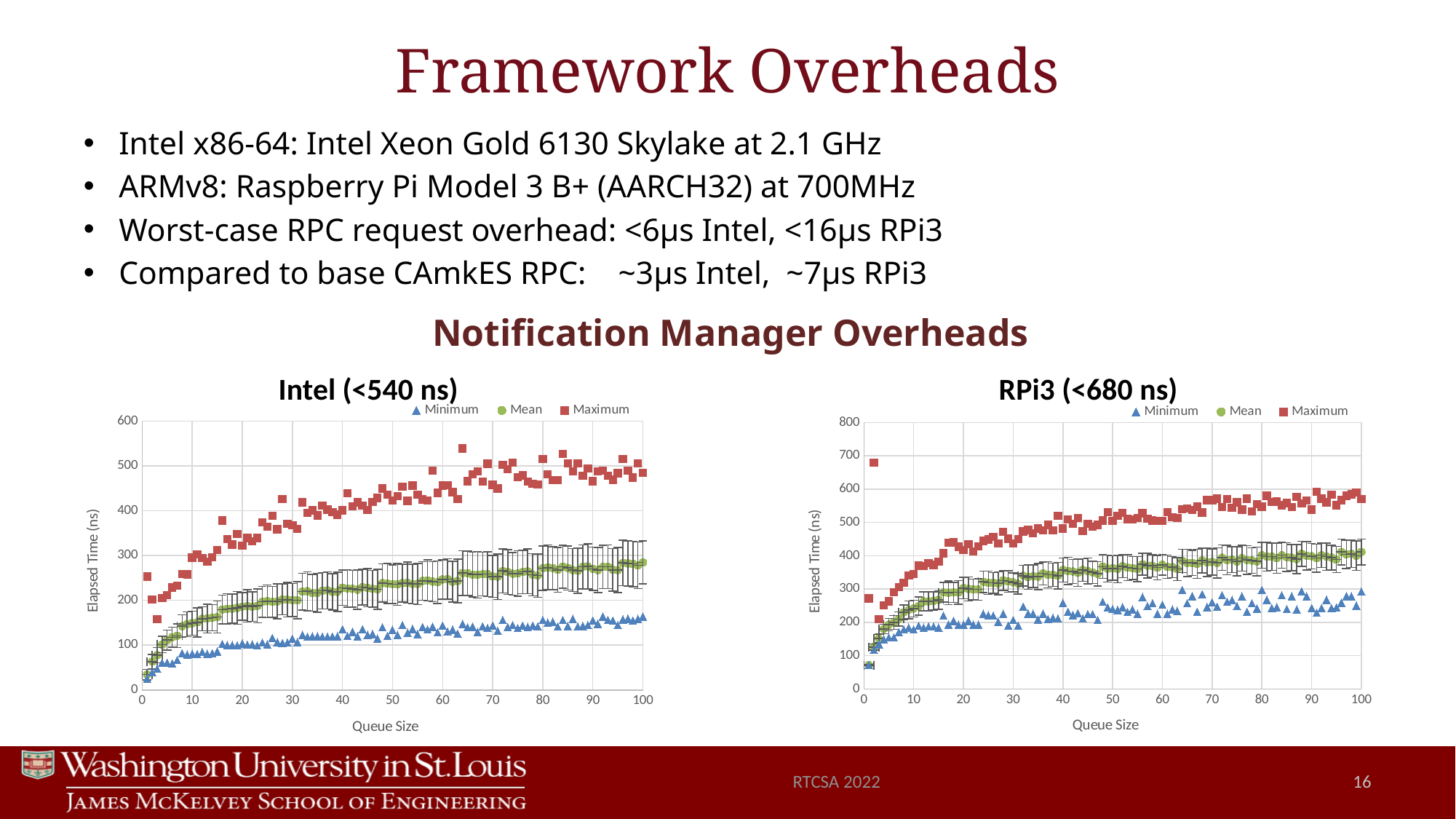
In the RPi3 (<680 ns) chart, which series has the larger value at queue size 80, Mean or Minimum? Mean What kind of chart is the Intel (<540 ns) chart? scatter chart How many series does the legend of the RPi3 (<680 ns) chart list? 3 In the Intel (<540 ns) chart, which series has the larger value at queue size 50, Maximum or Minimum? Maximum In the Intel (<540 ns) chart, does the Mean series rise or fall as Queue Size increases? rise In the RPi3 (<680 ns) chart, does the Maximum series rise or fall as Queue Size increases? rise In the Intel (<540 ns) chart, is the Minimum value at queue size 100 greater or less than 200? less What is the x-axis label on the RPi3 (<680 ns) chart? Queue Size What are the series names in the legend of the Intel (<540 ns) chart? Minimum, Mean, Maximum In the Intel (<540 ns) chart, is the Maximum value at queue size 100 greater or less than 400? greater In the RPi3 (<680 ns) chart, is the Maximum value at queue size 100 greater or less than 500? greater